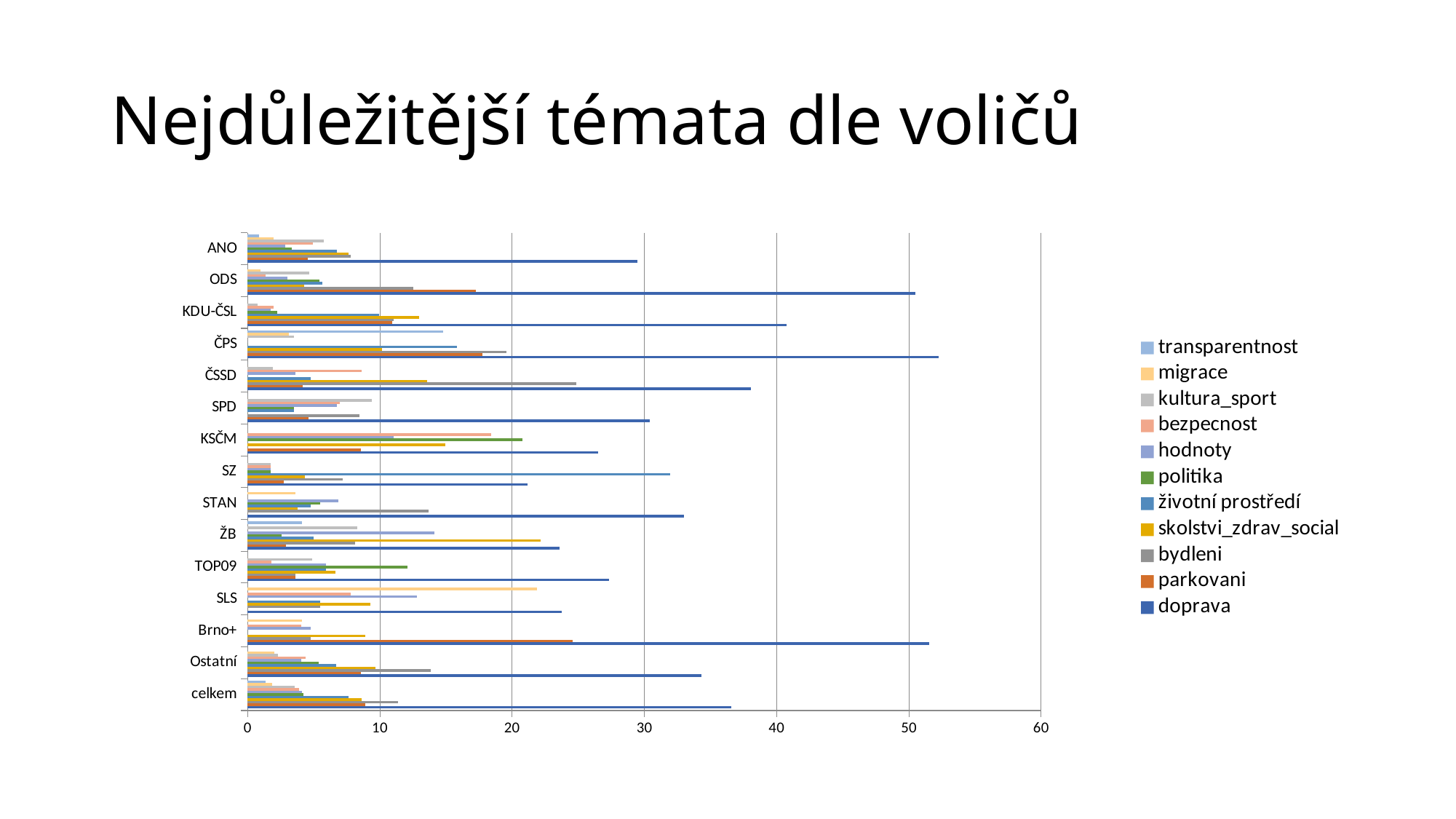
What kind of chart is shown on the slide? bar chart Is the value of migrace for SLS greater or less than 20? greater Which is larger, the doprava value for ODS or the doprava value for ANO? ODS Is the value of doprava for celkem greater or less than 30? greater Is the value of doprava for ODS greater or less than 40? greater Which series is listed last in the chart's legend? doprava How many categories (parties/groups) are listed on the vertical axis of the chart? 15 How many series does the chart's legend list? 11 What is the title of the slide containing the chart? Nejdůležitější témata dle voličů